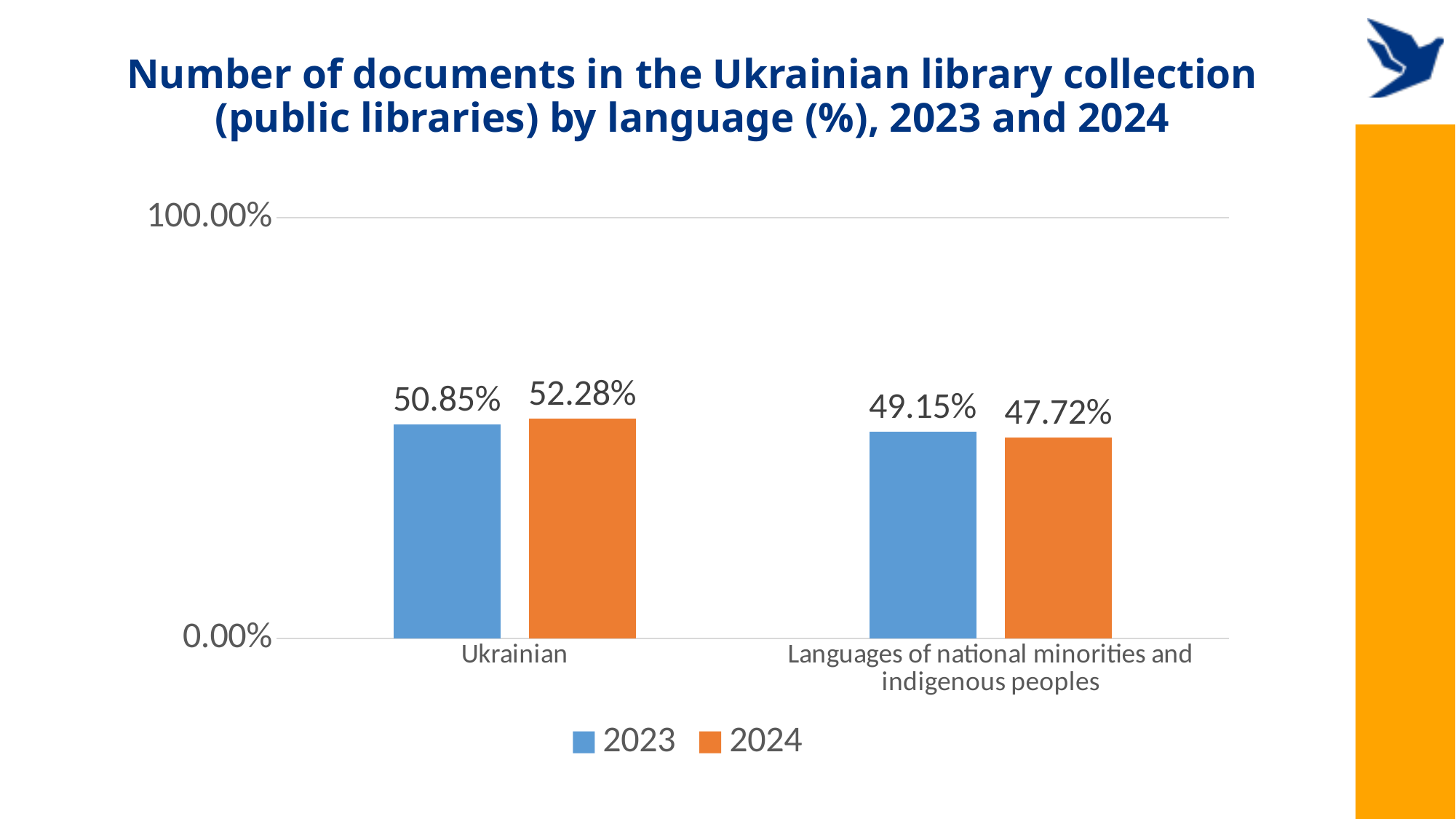
Which is larger: the 2023 share for Ukrainian or the 2023 share for languages of national minorities and indigenous peoples? Ukrainian What percentage of documents were in languages of national minorities and indigenous peoples in 2024? 47.72% Which language category had the highest share in 2024? Ukrainian How many language categories are shown on the x axis? 2 What percentage of documents were in Ukrainian in 2024? 52.28% Which language category had the lowest share in 2023? Languages of national minorities and indigenous peoples Which colour represents 2024 in the chart? Orange What percentage of documents were in languages of national minorities and indigenous peoples in 2023? 49.15% What percentage of documents were in Ukrainian in 2023? 50.85% How many series does the legend list? 2 By how many percentage points did the share of Ukrainian-language documents change from 2023 to 2024? 1.43% What kind of chart is shown on the slide? Bar chart